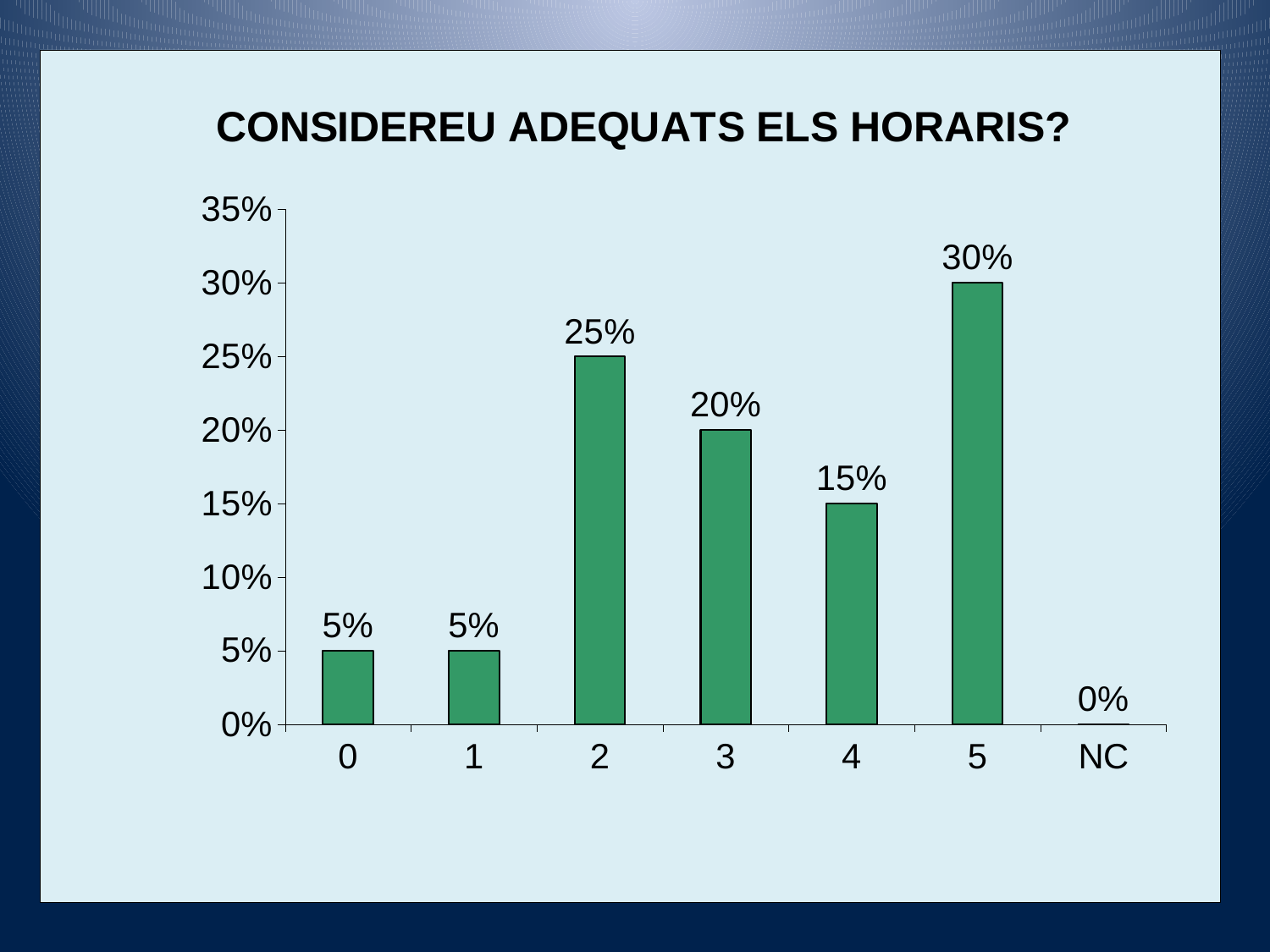
What is the value for category NC? 0% Is the value for category 4 greater or less than 10%? greater What kind of chart is shown? bar chart What is the difference between the values for category 5 and category 4? 15% Which category has the highest value? 5 What colour are the bars? green Which category has the lowest value? NC What is the value for category 5? 30% Which is larger, the value for category 2 or the value for category 3? 2 How many categories are shown on the x axis? 7 What is the title of the chart? CONSIDEREU ADEQUATS ELS HORARIS? What is the value for category 2? 25%